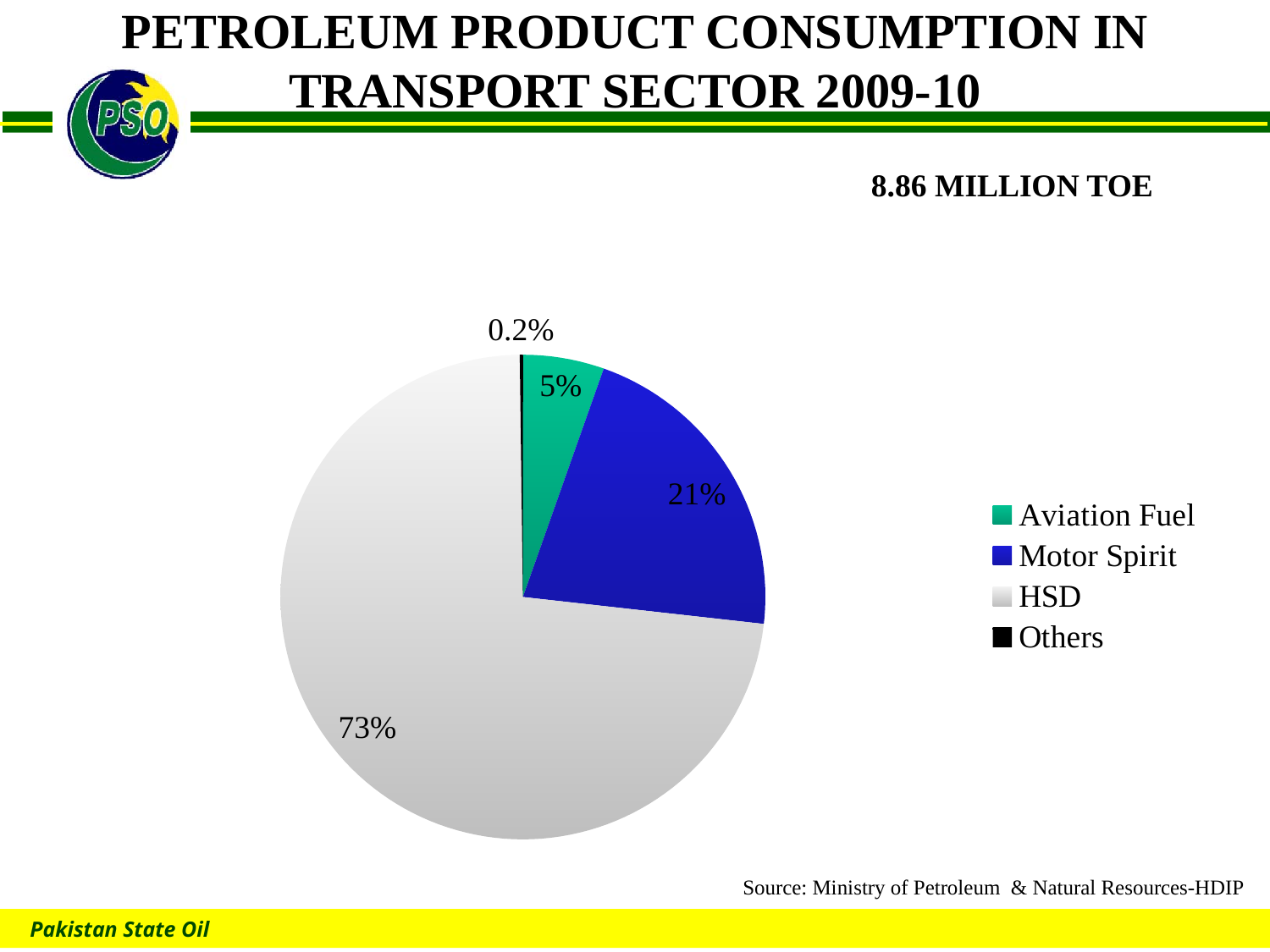
What share of consumption is Others? 0.2% What share of consumption is Aviation Fuel? 5% What total consumption figure is stated above the chart? 8.86 MILLION TOE What is the difference in percentage points between the HSD share and the Motor Spirit share? 52 What share of consumption is Motor Spirit? 21% What share of petroleum product consumption in the transport sector is HSD? 73% Which product has the smallest share of the pie? Others Which product has the largest share of the pie? HSD What type of chart is shown on the slide? pie chart How many categories does the legend list? 4 What colour represents Motor Spirit in the pie chart? blue Which has a larger share, Motor Spirit or Aviation Fuel? Motor Spirit